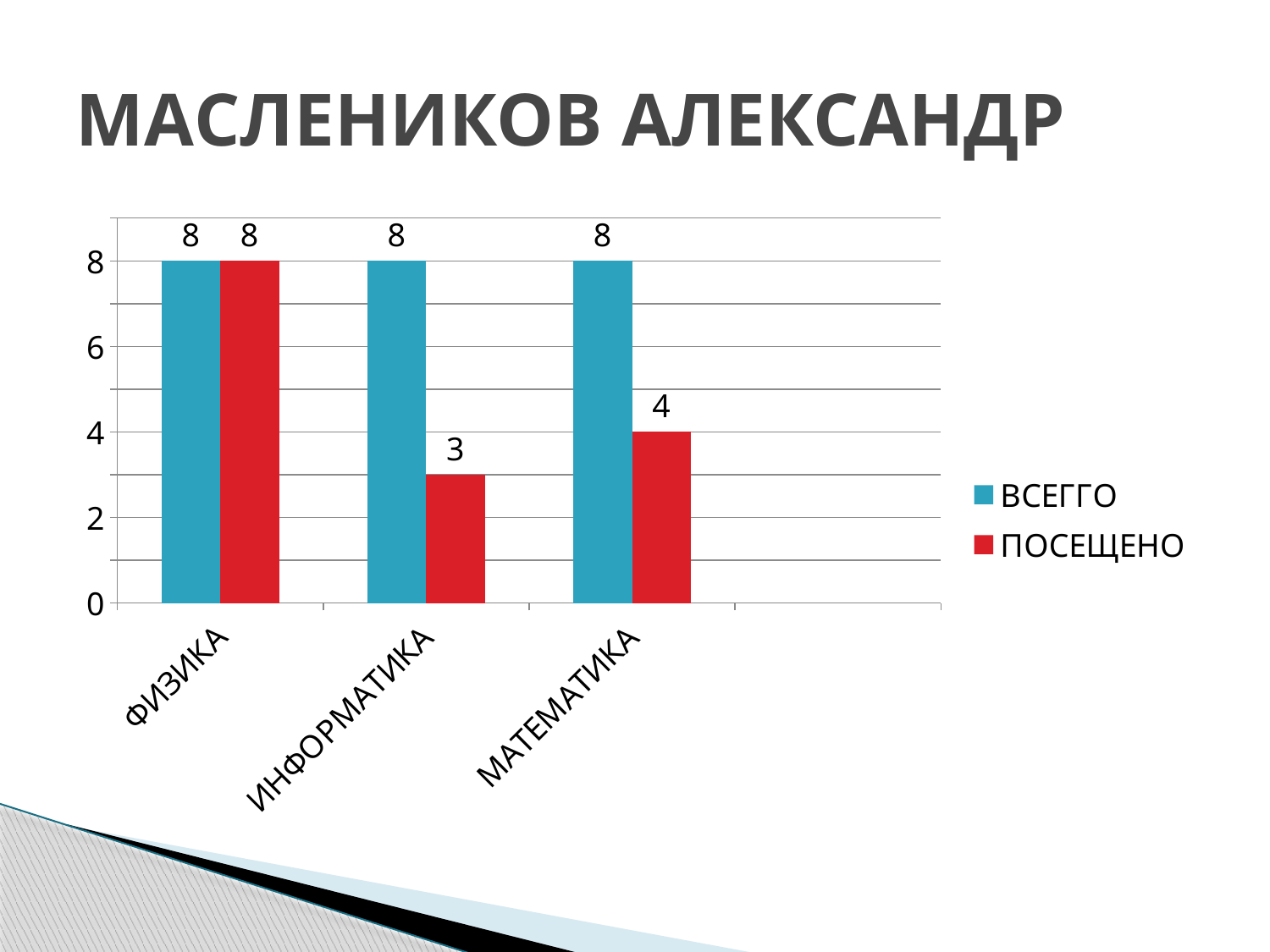
How many categories are shown on the x axis? 3 What is the ПОСЕЩЕНО value for МАТЕМАТИКА? 4 What is the ПОСЕЩЕНО value for ИНФОРМАТИКА? 3 What is the ПОСЕЩЕНО value for ФИЗИКА? 8 What is the difference between the ВСЕГГО and ПОСЕЩЕНО values for МАТЕМАТИКА? 4 What is the difference between the ВСЕГГО and ПОСЕЩЕНО values for ИНФОРМАТИКА? 5 What kind of chart is shown on the slide? Bar chart How many series does the legend list? 2 Which is larger, the ПОСЕЩЕНО value for МАТЕМАТИКА or for ИНФОРМАТИКА? МАТЕМАТИКА Which category has the highest ПОСЕЩЕНО value? ФИЗИКА Which category has the lowest ПОСЕЩЕНО value? ИНФОРМАТИКА What is the ВСЕГГО value for ФИЗИКА? 8